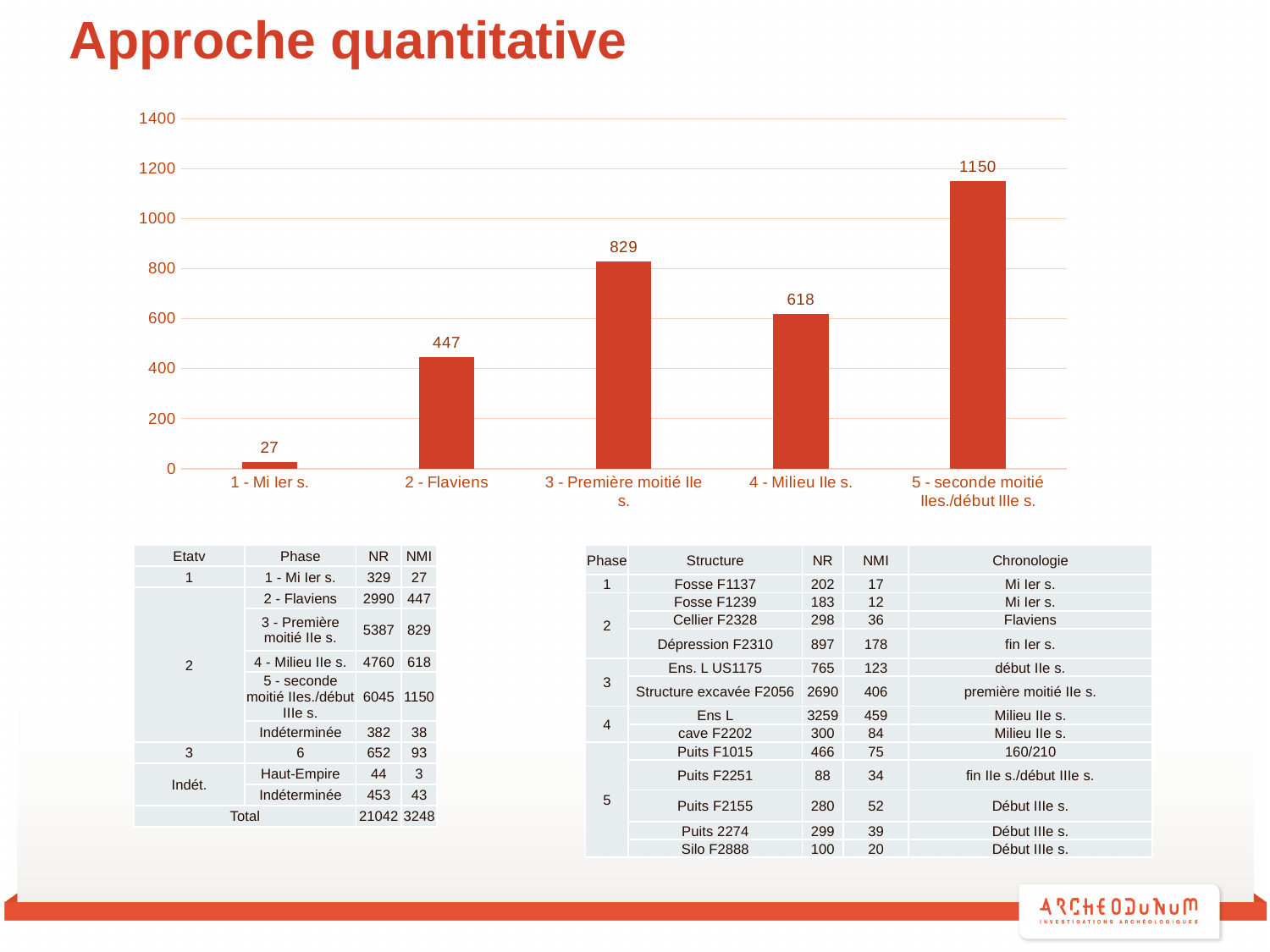
What is the value for the category '2 - Flaviens'? 447 What is the difference between the values for '4 - Milieu IIe s.' and '2 - Flaviens'? 171 What kind of chart is shown on the slide? bar chart What is the difference between the values for '5 - seconde moitié IIes./début IIIe s.' and '3 - Première moitié IIe s.'? 321 Which is larger, the value for '3 - Première moitié IIe s.' or the value for '4 - Milieu IIe s.'? 3 - Première moitié IIe s. Which category has the highest value? 5 - seconde moitié IIes./début IIIe s. Is the value for '3 - Première moitié IIe s.' greater or less than 800? greater Which category has the lowest value? 1 - Mi Ier s. What is the value for the category '4 - Milieu IIe s.'? 618 Do the values rise or fall from '2 - Flaviens' to '3 - Première moitié IIe s.'? rise What is the value for the category '1 - Mi Ier s.'? 27 How many categories are shown on the x axis of the chart? 5